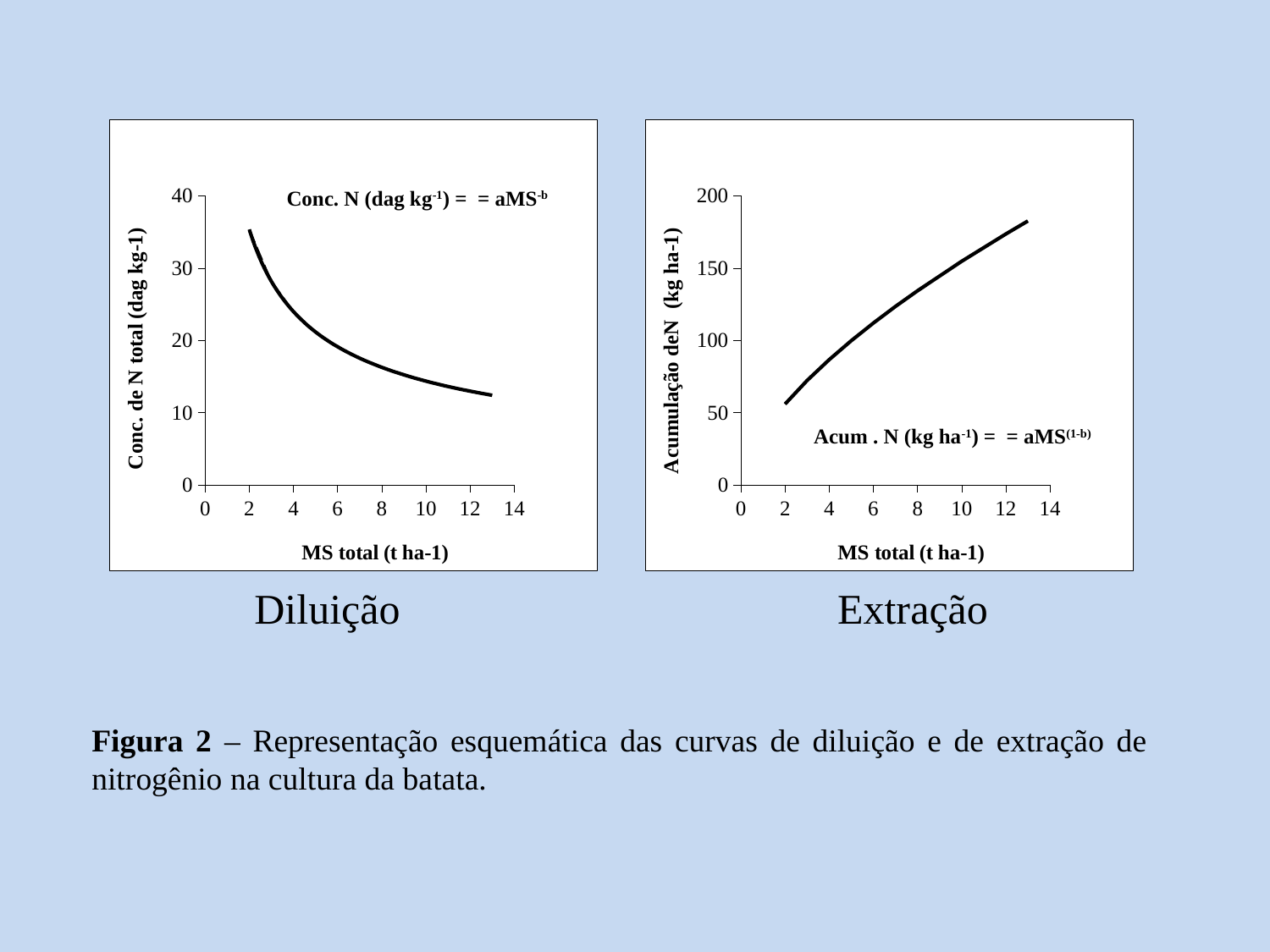
In the Diluição chart, is the value of Conc. de N total at MS total of 12 greater or less than 20? less In the Diluição chart, does the curve rise or fall as MS total increases? fall In the Diluição chart, is the value of Conc. de N total at MS total of 2 greater or less than 30? greater In the Extração chart, does the curve rise or fall as MS total increases? rise What kind of chart is the left chart labelled Diluição? line chart What is the x-axis label of the Diluição chart? MS total (t ha-1) In the Extração chart, is the value of Acumulação de N at MS total of 12 greater or less than 150? greater What kind of chart is the right chart labelled Extração? line chart How many charts are shown on the slide? 2 What is the y-axis label of the Extração chart? Acumulação deN (kg ha-1)